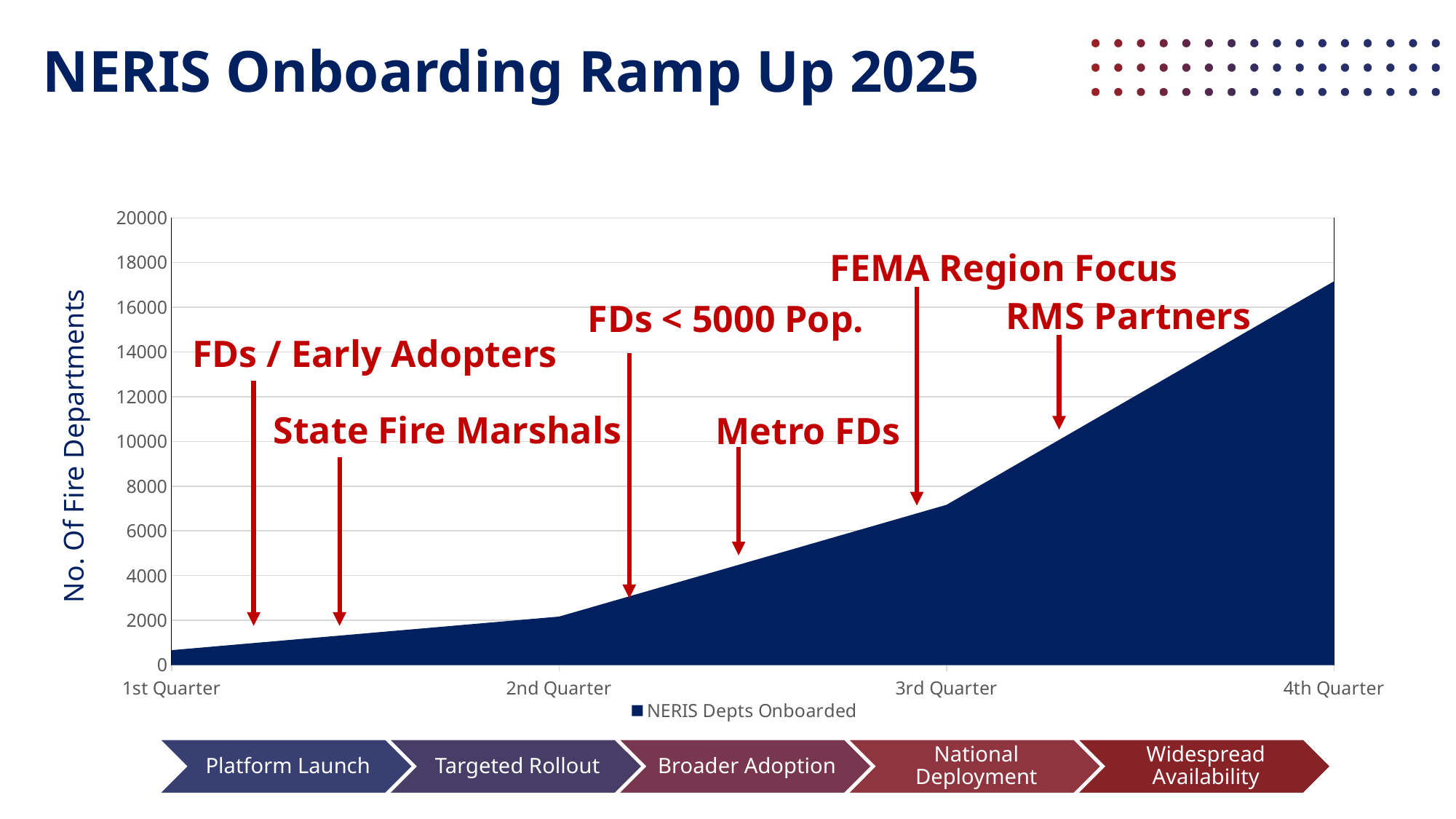
What is the title of the y axis? No. Of Fire Departments Is the value for 2nd Quarter greater or less than 4000? less What kind of chart is shown on the slide? area chart Which quarter has the lowest number of NERIS Depts Onboarded? 1st Quarter Is the value for 3rd Quarter greater or less than 8000? less How many quarters are labelled on the x axis? 4 Which quarter has the highest number of NERIS Depts Onboarded? 4th Quarter What is the name of the series shown in the legend? NERIS Depts Onboarded Is the value for 4th Quarter greater or less than 14000? greater How many series does the legend list? 1 Do the values rise or fall from 1st Quarter to 4th Quarter? rise Which is larger, the value for 3rd Quarter or the value for 2nd Quarter? 3rd Quarter